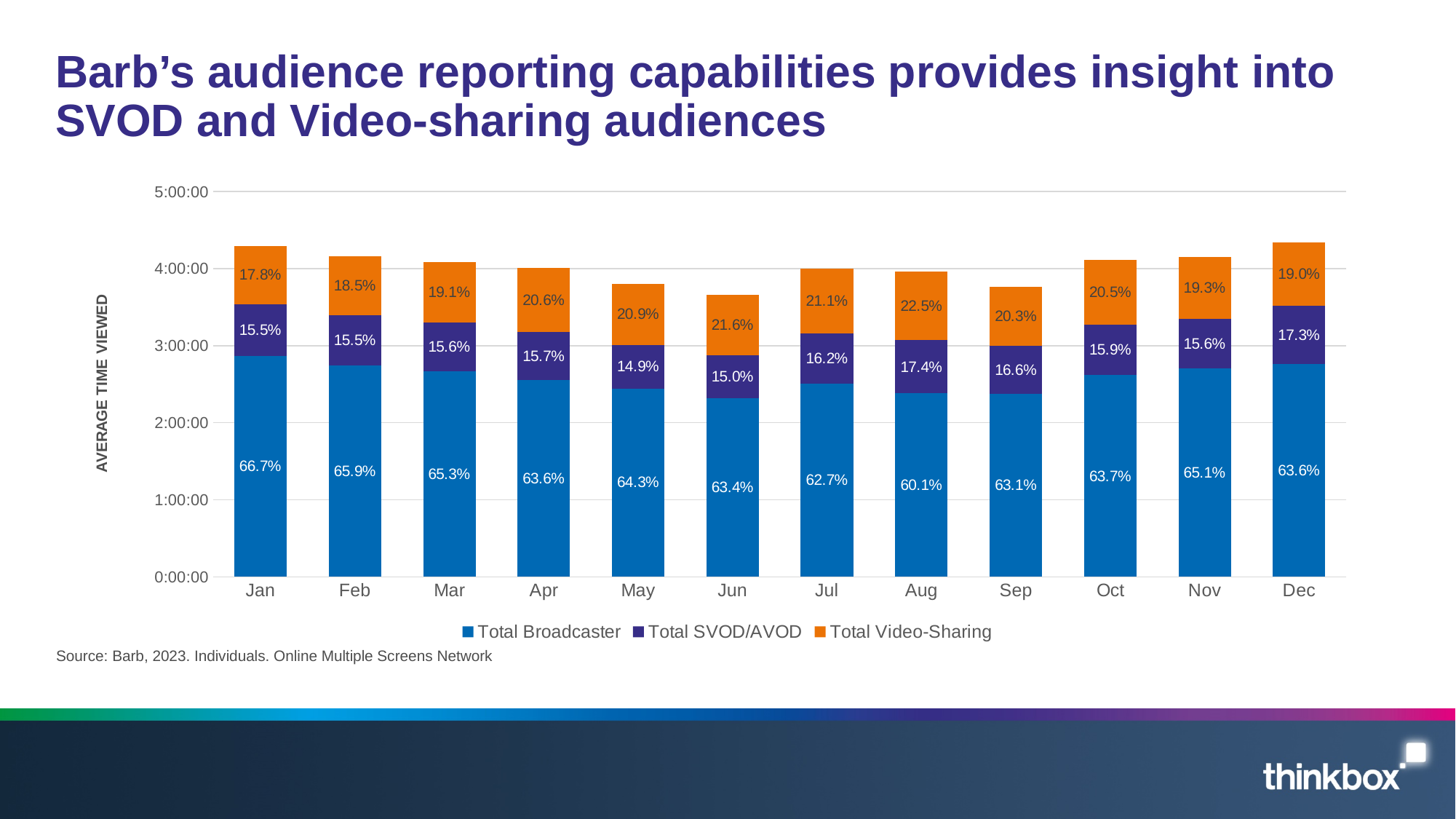
What is the Total Broadcaster label for Jan? 66.7% How many series does the legend list? 3 Which month has the lowest Total SVOD/AVOD label? May Which month has the lowest Total Broadcaster label? Aug Which month has the highest Total Video-Sharing label? Aug What is the Total Video-Sharing label for Aug? 22.5% What is the difference between the Total Broadcaster labels for Jan and Aug? 6.6 percentage points How many months are shown on the x axis? 12 Which is larger, the Total Video-Sharing label for Jun or for Jul? Jun Is the total height of the Jun bar greater or less than 4:00:00? less What is the Total SVOD/AVOD label for Dec? 17.3% Is the total height of the Jan bar greater or less than 4:00:00? greater